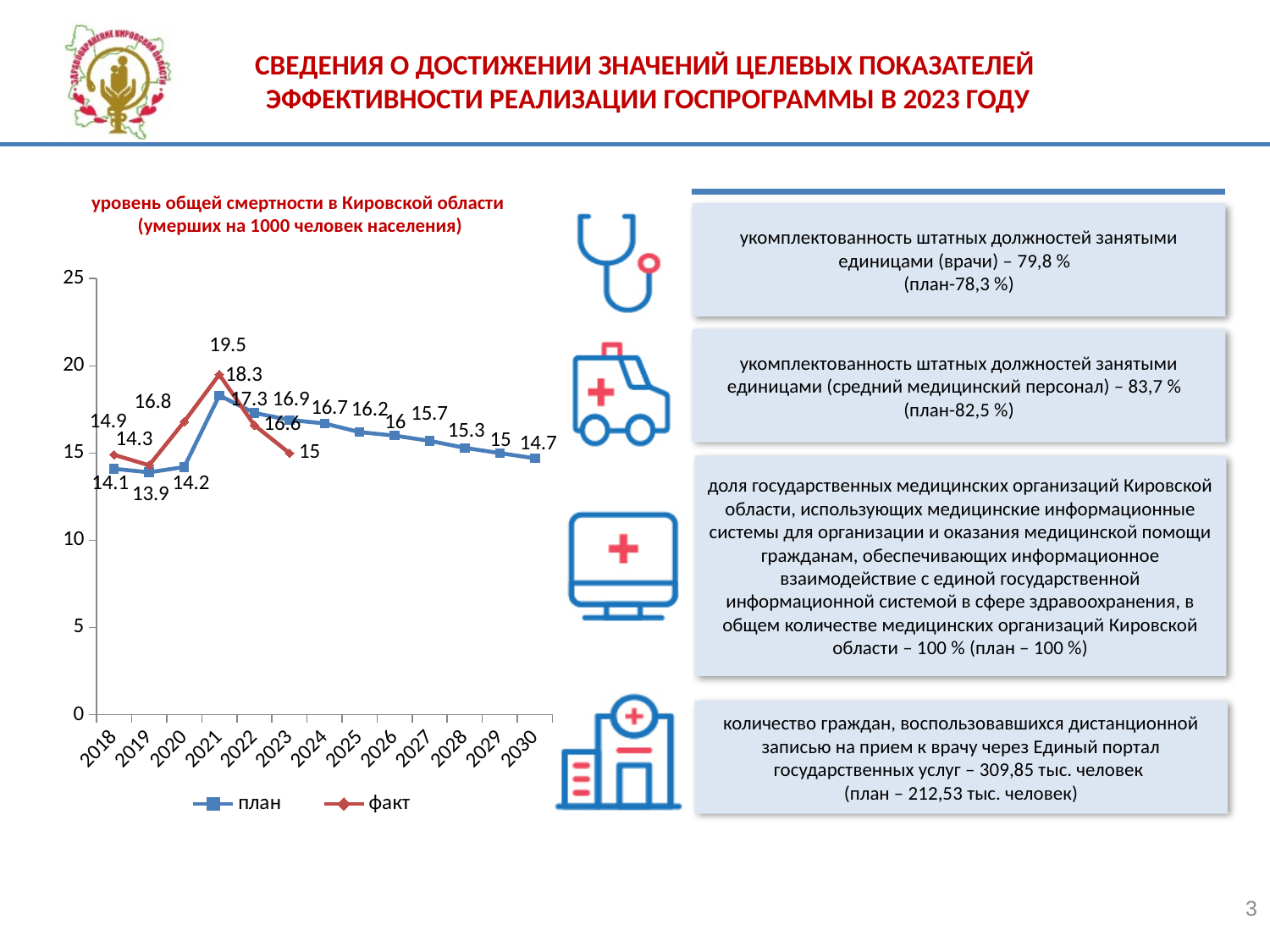
What kind of chart is shown on the slide? line chart What is the difference between the факт and план values in 2021? 1.2 What are the two series named in the chart legend? план and факт What is the факт value for 2023? 15 In which year is the план series at its lowest value? 2019 In 2020, which is larger: the план value or the факт value? факт In which year does the факт series reach its highest value? 2021 What is the план value for 2030? 14.7 Does the план series rise or fall from 2021 to 2030? fall How many years are shown on the x axis of the chart? 13 What is the факт value for 2021? 19.5 How many series does the chart legend list? 2